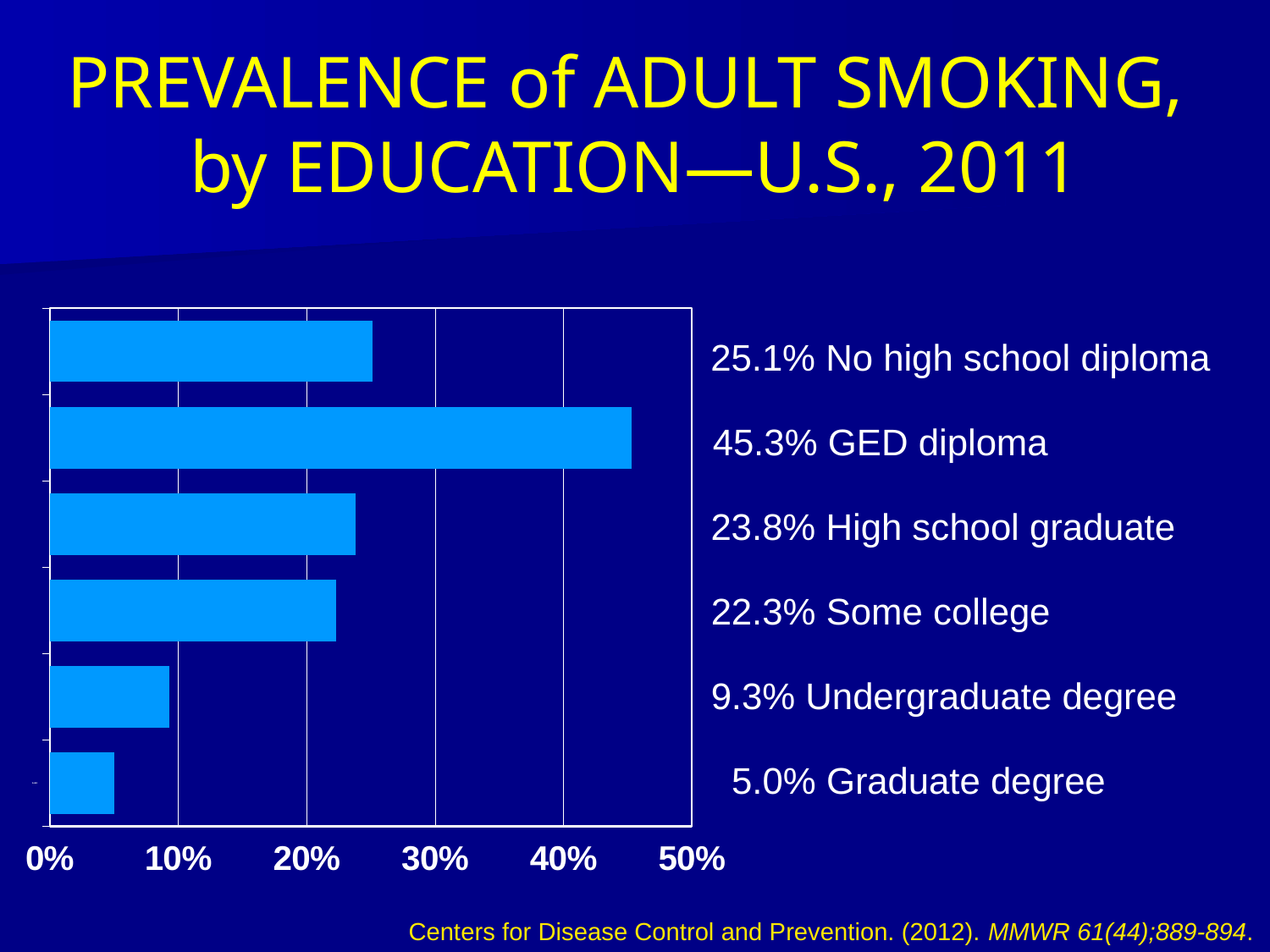
What is the difference in smoking prevalence between Undergraduate degree and Graduate degree? 4.3% Which education category has the lowest smoking prevalence? Graduate degree What is the smoking prevalence for adults with a graduate degree? 5.0% What is the difference in smoking prevalence between GED diploma and No high school diploma? 20.2% Is the smoking prevalence for GED diploma greater or less than 40%? greater Which has a higher smoking prevalence, No high school diploma or High school graduate? No high school diploma Which education category has the highest smoking prevalence? GED diploma What is the smoking prevalence for adults with a GED diploma? 45.3% What is the title of the slide? PREVALENCE of ADULT SMOKING, by EDUCATION—U.S., 2011 How many education categories are shown in the chart? 6 What type of chart is shown on the slide? Bar chart What is the smoking prevalence for adults with some college? 22.3%